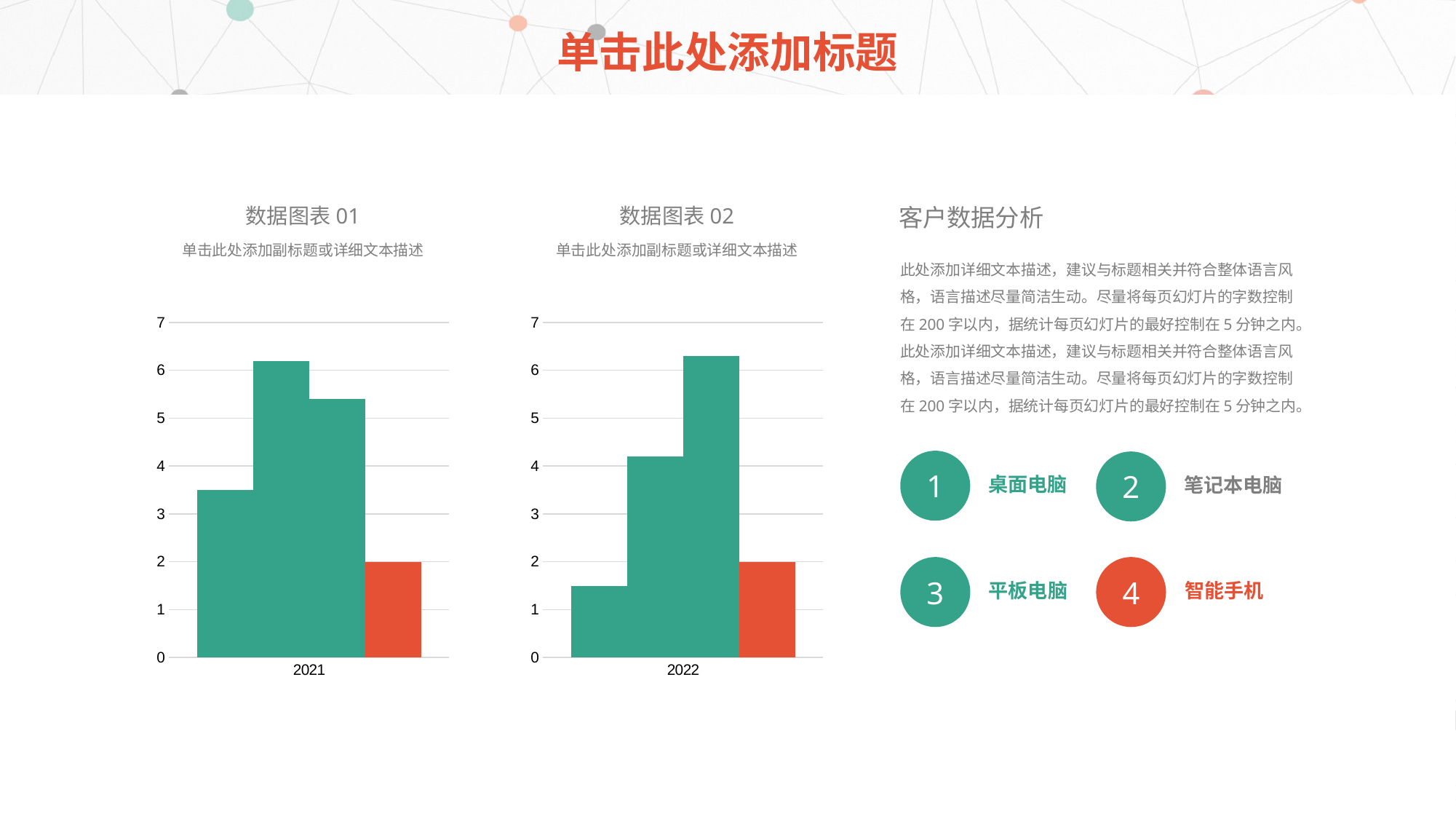
In the chart titled 数据图表 01, what kind of chart is shown? bar chart In the chart titled 数据图表 01, which bar is the shortest? the fourth (red) bar In the chart titled 数据图表 01, how many bars are plotted? 4 In the chart titled 数据图表 01, is the value of the second bar greater or less than 6? greater In the chart titled 数据图表 01, what is the value of the red (fourth) bar? 2 In the chart titled 数据图表 02, what kind of chart is shown? bar chart In the chart titled 数据图表 02, what is the value of the red (fourth) bar? 2 In the chart titled 数据图表 01, which bar is the tallest? the second bar In the chart titled 数据图表 01, which is larger, the first bar or the fourth bar? the first bar In the chart titled 数据图表 02, which bar is the tallest? the third bar What is the x-axis category label shown in the chart titled 数据图表 02? 2022 In the chart titled 数据图表 02, is the value of the first bar greater or less than 2? less